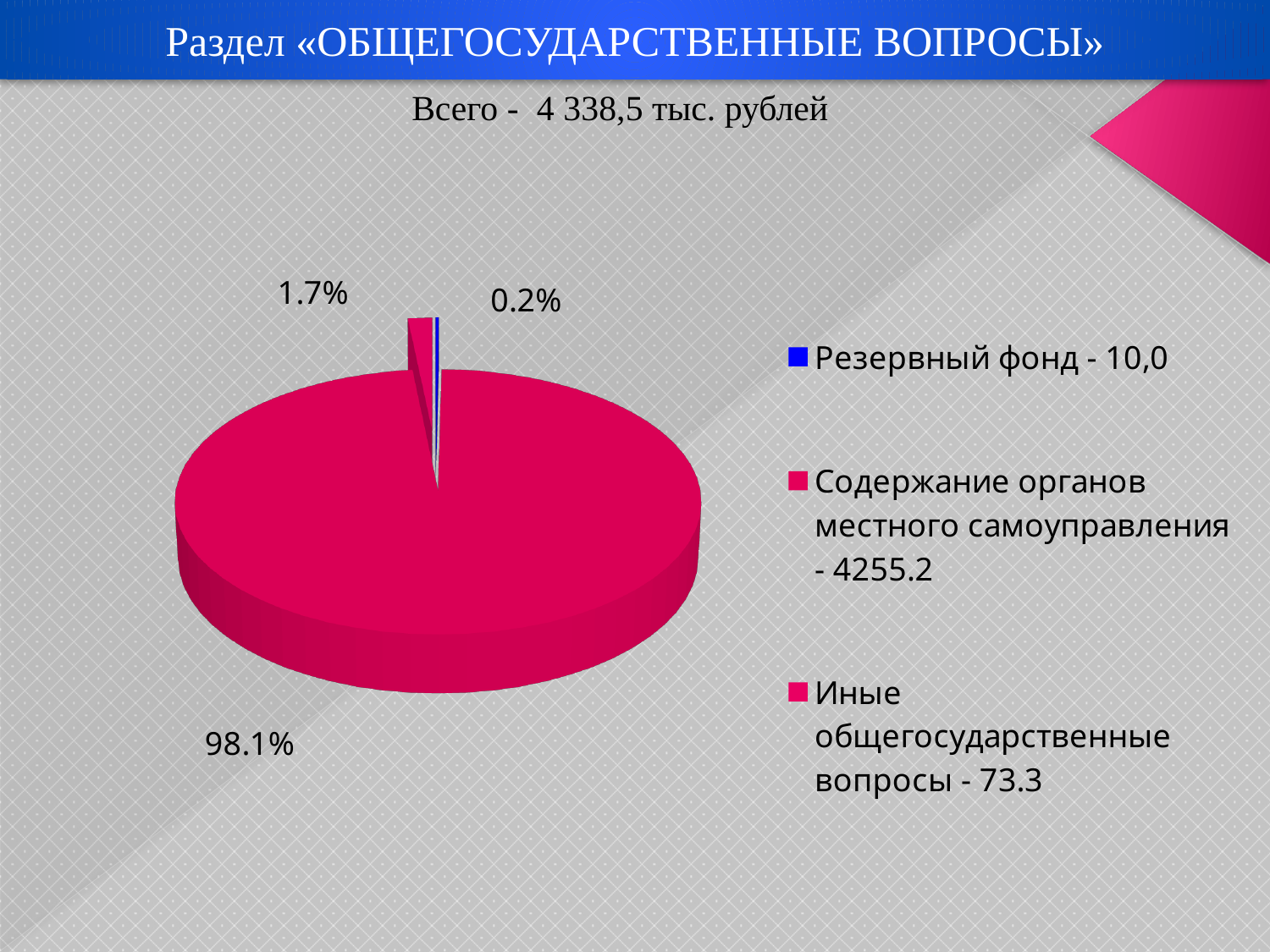
What value is given in the legend for "Резервный фонд"? 10,0 Which category has the largest slice of the pie? Содержание органов местного самоуправления What share of the pie does "Иные общегосударственные вопросы" take? 1.7% How many slices does the pie chart have? 3 What kind of chart is shown on the slide? pie chart What total amount is stated above the chart? 4 338,5 тыс. рублей What is the difference between the legend values for "Содержание органов местного самоуправления" (4255.2) and "Иные общегосударственные вопросы" (73.3)? 4181.9 What share of the pie does "Резервный фонд" take? 0.2% What share of the pie does "Содержание органов местного самоуправления" take? 98.1% Which is larger: the slice for "Иные общегосударственные вопросы" or the slice for "Резервный фонд"? Иные общегосударственные вопросы What value is given in the legend for "Иные общегосударственные вопросы"? 73.3 Which category has the smallest slice of the pie? Резервный фонд